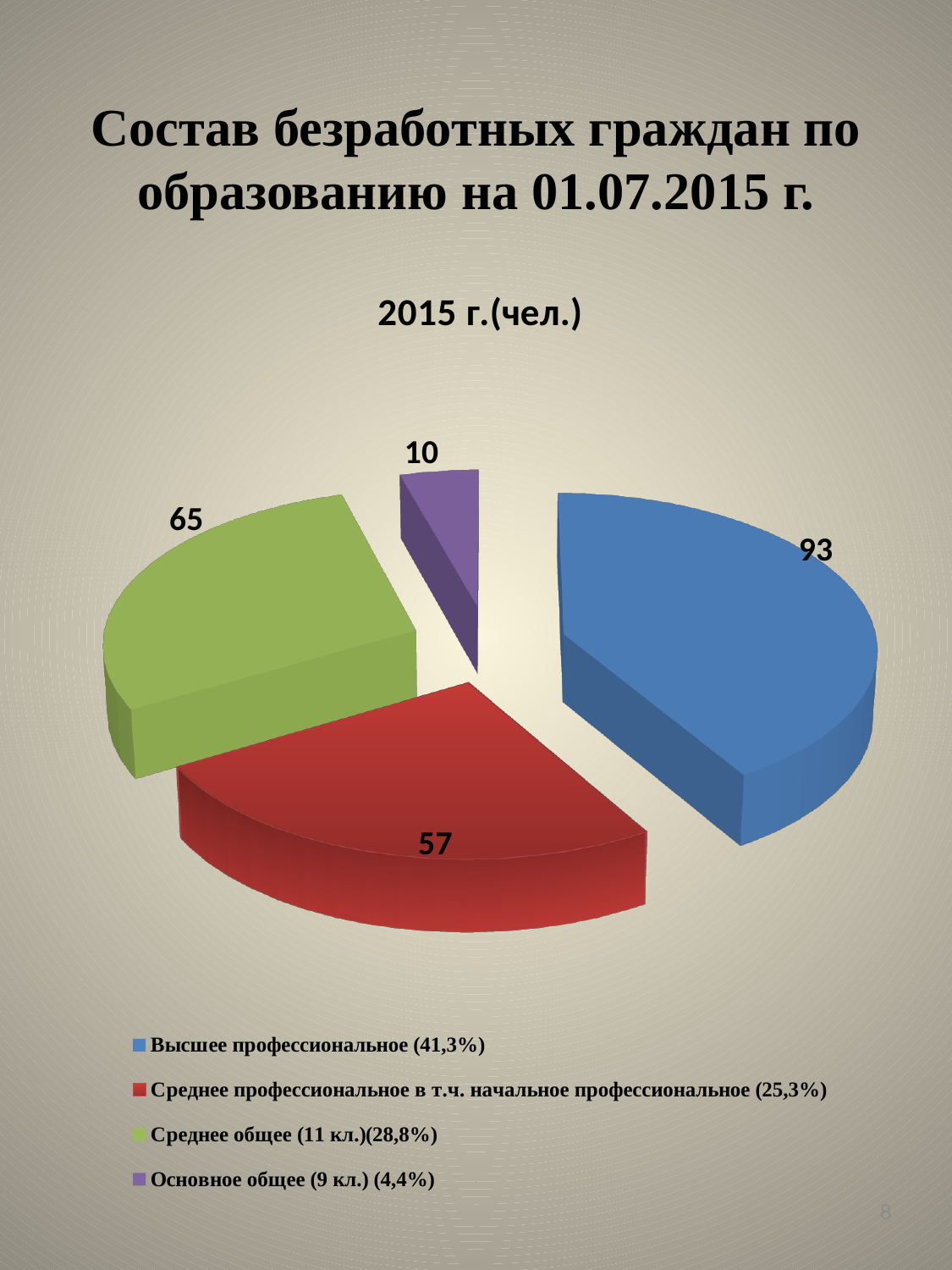
What is the value for Среднее общее (11 кл.)? 65 What is the value for Высшее профессиональное? 93 What is the difference between the values for Высшее профессиональное and Среднее общее (11 кл.)? 28 What is the value for Основное общее (9 кл.)? 10 What kind of chart is shown on the slide? pie chart Which category has the largest slice? Высшее профессиональное Which is larger: the value for Среднее общее (11 кл.) or the value for Среднее профессиональное в т.ч. начальное профессиональное? Среднее общее (11 кл.) What is the value for Среднее профессиональное в т.ч. начальное профессиональное? 57 What share of the pie does Среднее общее (11 кл.) represent, as shown in the legend? 28,8% What is the title of the chart? 2015 г.(чел.) Which category has the smallest slice? Основное общее (9 кл.) How many slices does the pie chart have? 4